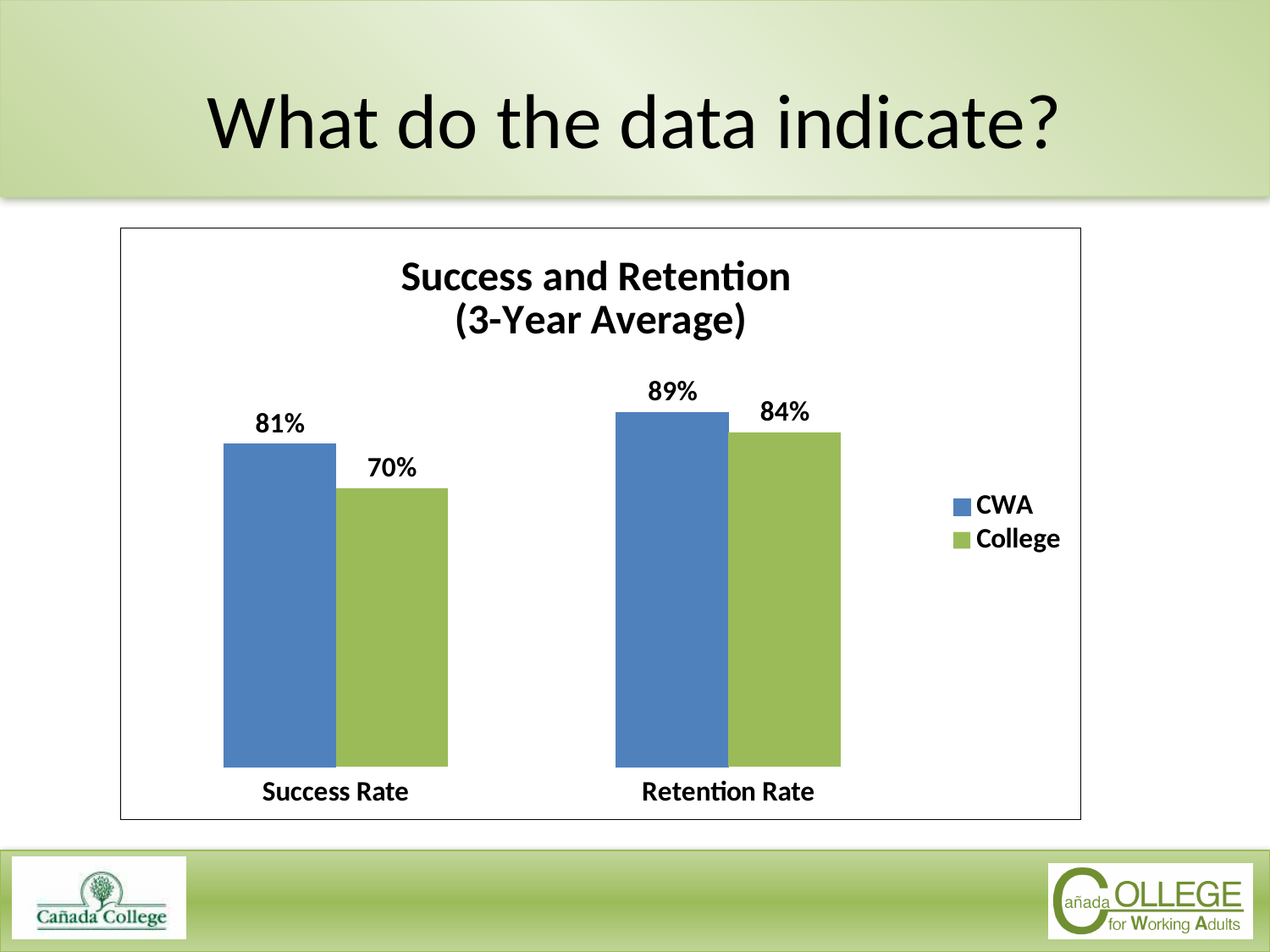
Which is larger, the CWA Success Rate or the College Success Rate? CWA Success Rate How many series does the legend list? 2 Which bar has the lowest value in the chart? College Success Rate What is the difference between the CWA and College Success Rates? 11% What is the CWA Retention Rate? 89% What is the title of the chart? Success and Retention (3-Year Average) What kind of chart is shown on the slide? Bar chart What is the CWA Success Rate? 81% What is the College Retention Rate? 84% Which bar has the highest value in the chart? CWA Retention Rate What is the difference between the CWA and College Retention Rates? 5% What is the College Success Rate? 70%